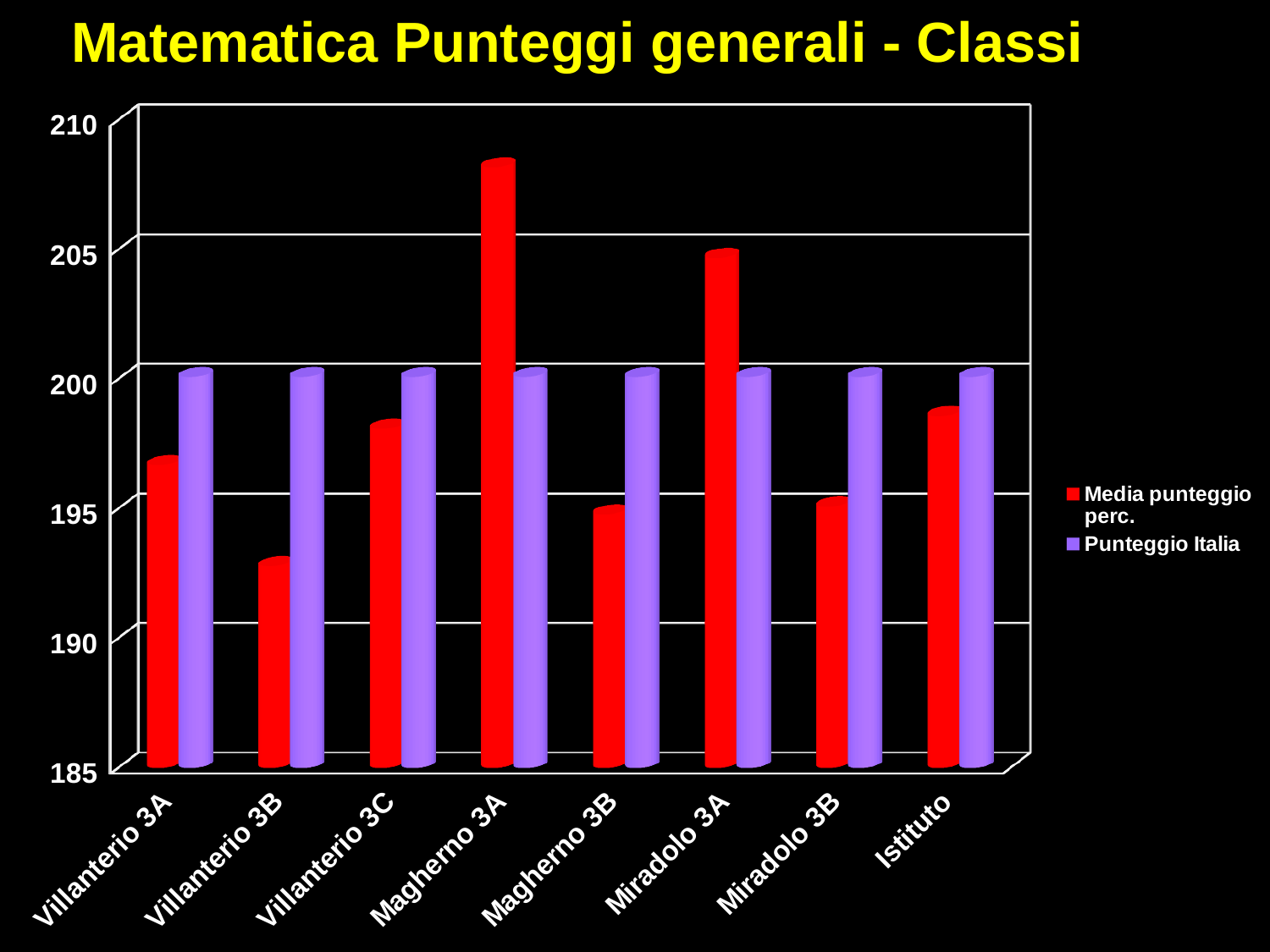
What kind of chart is shown on the slide? bar chart Which is larger, the Media punteggio perc. for Magherno 3A or for Miradolo 3A? Magherno 3A Which category has the highest value for Media punteggio perc.? Magherno 3A Is the value of Media punteggio perc. for Villanterio 3B greater or less than 195? less How many categories are shown on the x axis? 8 How many series does the legend list? 2 Which category has the lowest value for Media punteggio perc.? Villanterio 3B What is the title of the chart? Matematica Punteggi generali - Classi Is the value of Media punteggio perc. for Magherno 3A greater or less than 205? greater Which colour represents the Punteggio Italia series? purple Is the value of Media punteggio perc. for Istituto greater or less than 200? less